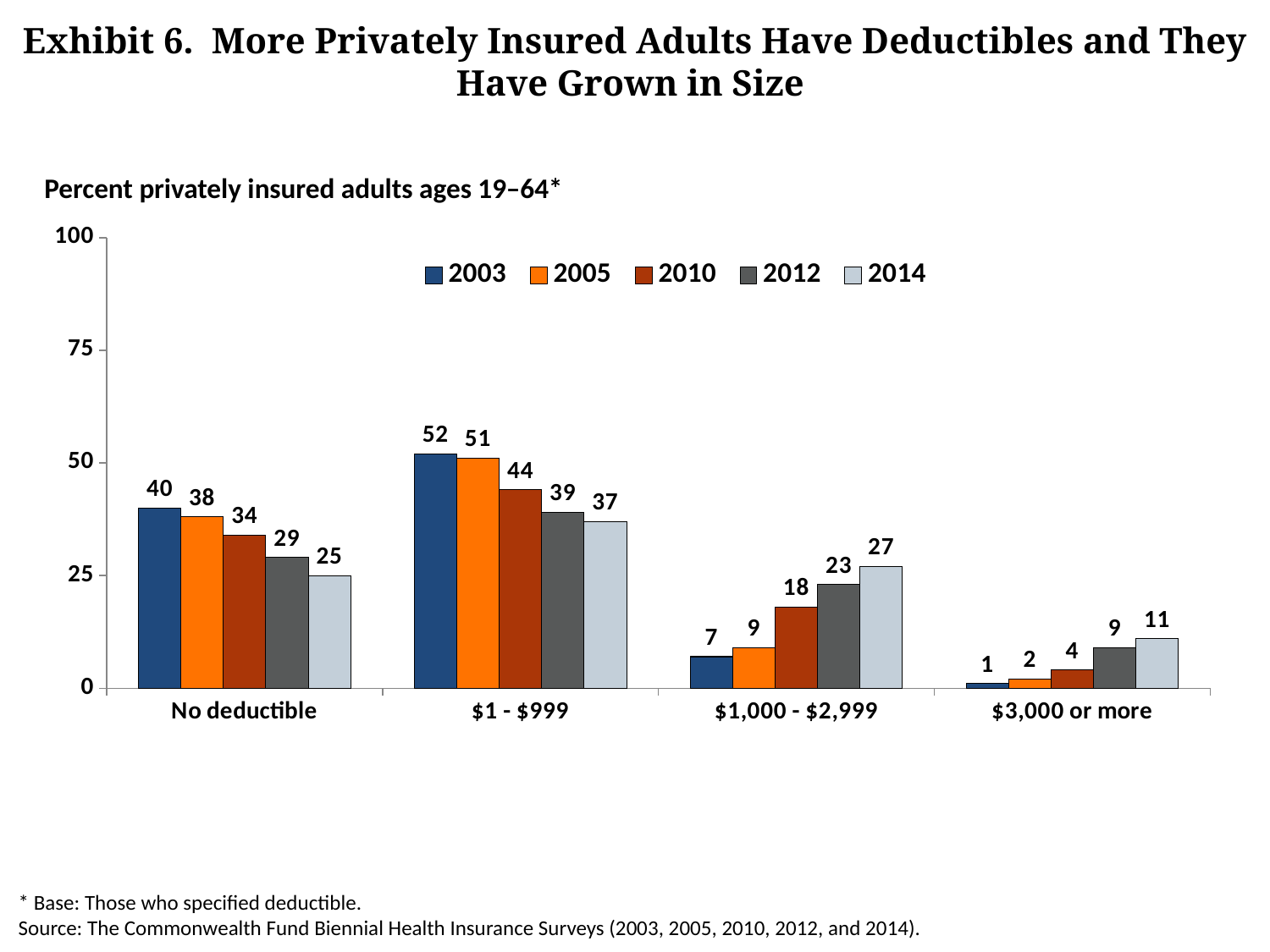
Which year has the lowest value in the "No deductible" category? 2014 Which is larger: the 2012 value for "$1,000 - $2,999" or the 2012 value for "No deductible"? No deductible What is the value for 2014 in the "No deductible" category? 25 What kind of chart is shown on the slide? Bar chart How many deductible categories are shown on the x axis? 4 What is the value for 2010 in the "$1,000 - $2,999" category? 18 Which year has the highest value in the "$3,000 or more" category? 2014 What is the difference between the 2003 and 2014 values in the "No deductible" category? 15 What is the value for 2003 in the "$1 - $999" category? 52 Do the values in the "$1,000 - $2,999" category rise or fall from 2003 to 2014? Rise What is the label on the y axis of the chart? Percent privately insured adults ages 19–64* How many series does the legend list? 5